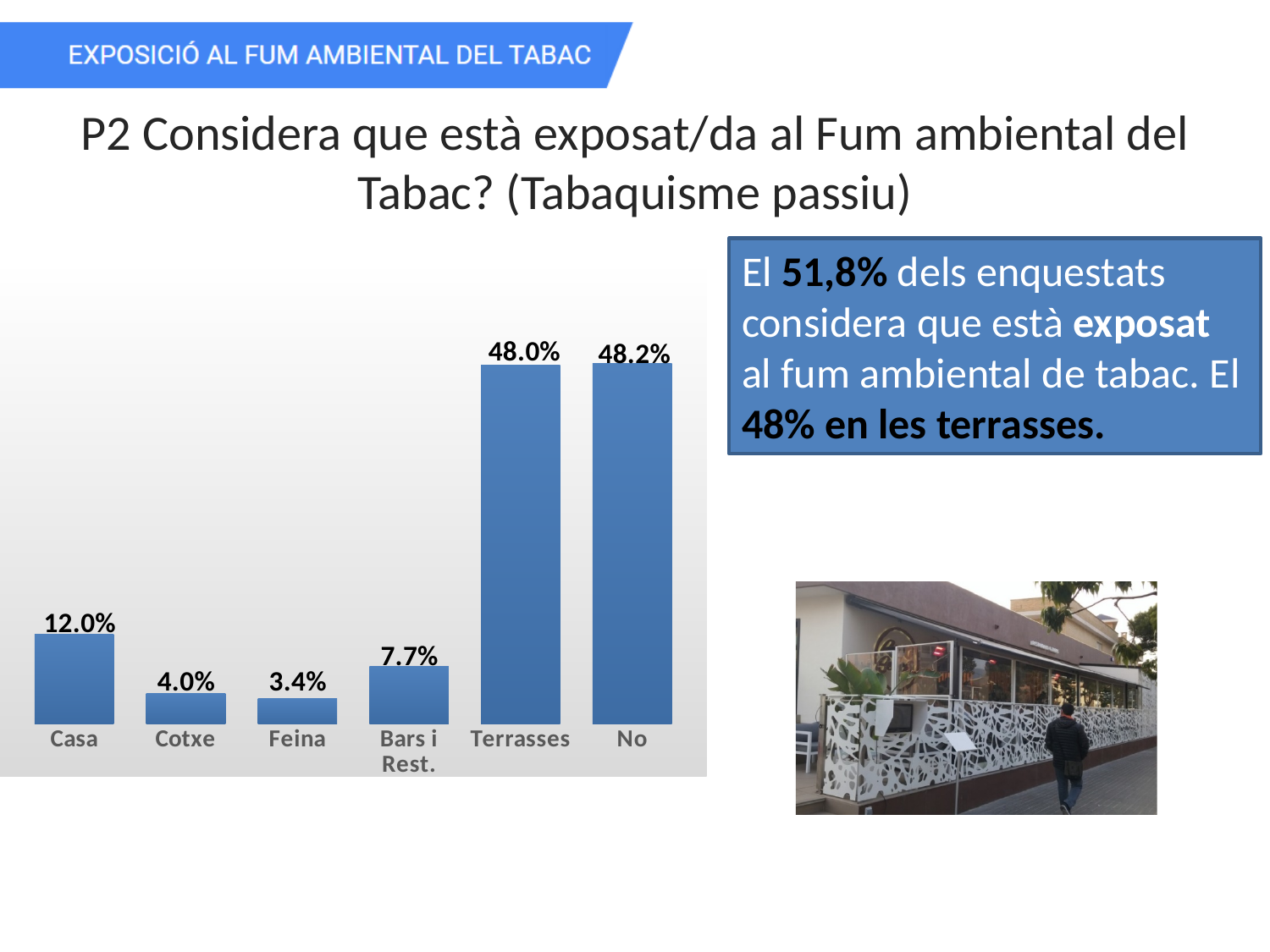
What is the value for Cotxe? 4.0% Which is larger, the value for Casa or the value for Bars i Rest.? Casa How many categories are shown in the chart? 6 Which category has the lowest value? Feina What is the value for Bars i Rest.? 7.7% What is the value for Terrasses? 48.0% What kind of chart is shown on the slide? Bar chart Which category has the highest value? No What is the difference between the values for Bars i Rest. and Feina? 4.3% What is the value for No? 48.2% What is the difference between the values for Casa and Cotxe? 8.0% What is the value for Casa? 12.0%